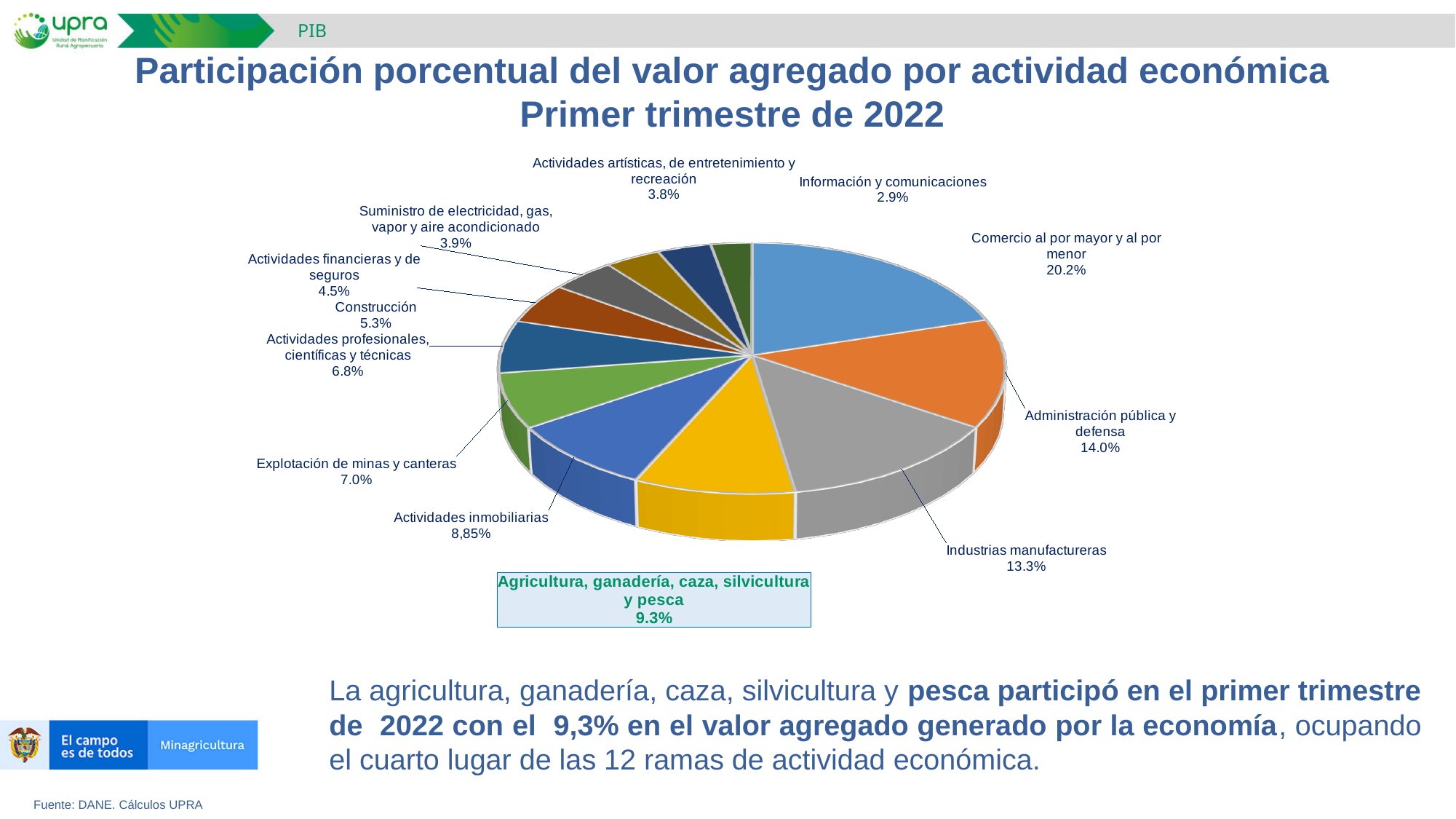
What is the share for Información y comunicaciones? 2.9% What is the difference in percentage points between Comercio al por mayor y al por menor and Administración pública y defensa? 6.2 What is the share for Agricultura, ganadería, caza, silvicultura y pesca? 9.3% What kind of chart is shown on the slide? Pie chart Which economic activity has the largest share of the pie? Comercio al por mayor y al por menor What is the share for Comercio al por mayor y al por menor? 20.2% How many economic activities (slices) are shown in the pie chart? 12 What is the title of the chart? Participación porcentual del valor agregado por actividad económica Primer trimestre de 2022 What is the share for Industrias manufactureras? 13.3% Which has a larger share, Explotación de minas y canteras or Construcción? Explotación de minas y canteras Which economic activity has the smallest share of the pie? Información y comunicaciones What is the share for Actividades inmobiliarias? 8,85%